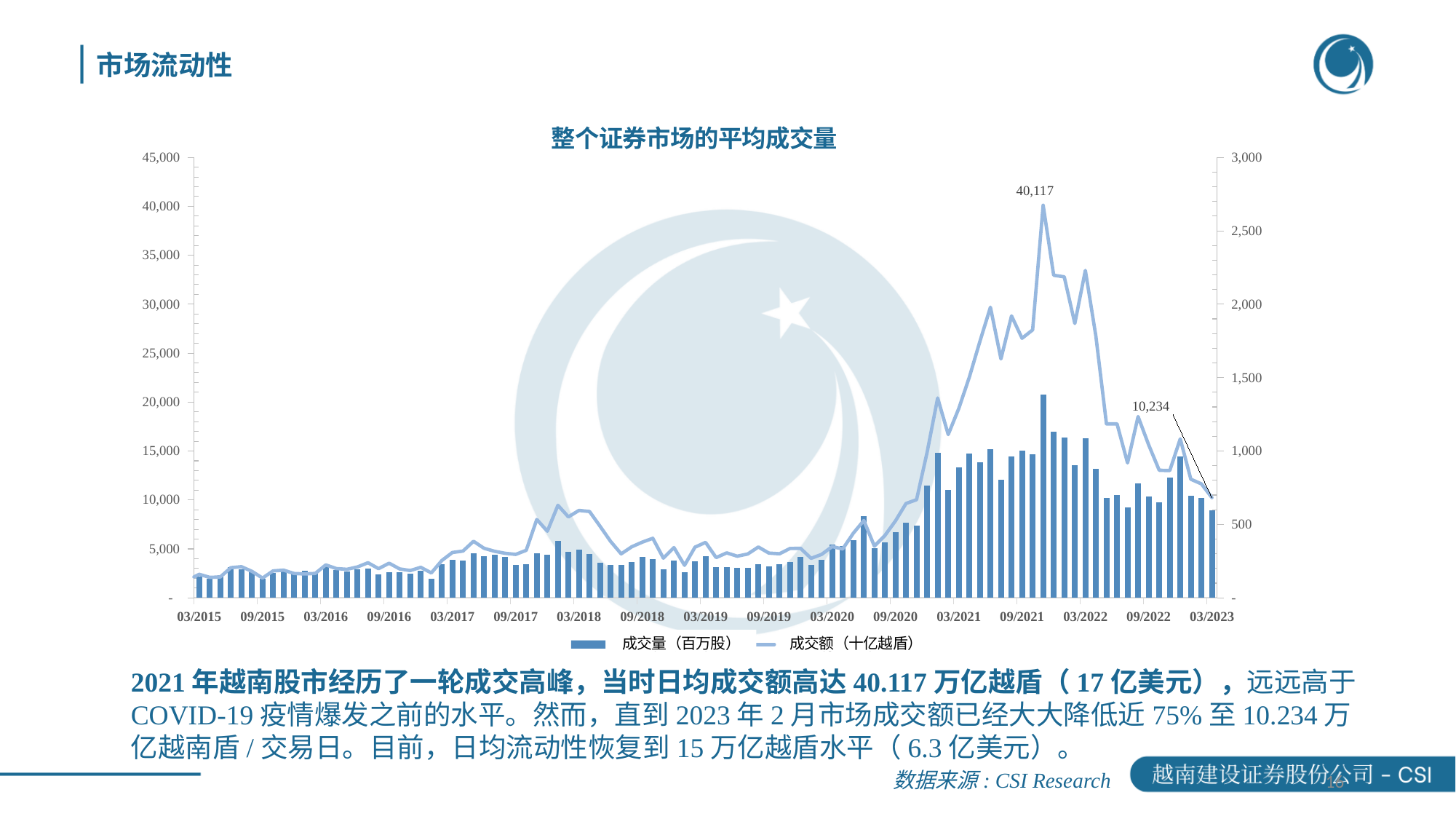
How many date labels are shown on the x axis? 17 What is the difference between the two labeled values on the 成交额 line, 40,117 and 10,234? 29,883 What kind of chart is shown on the slide? Combined bar and line chart Which is larger, the 成交量 bar at 03/2021 or the 成交量 bar at 03/2016? 03/2021 What value is labeled at the end of the 成交额 line near 03/2023? 10,234 How many series does the legend list? 2 Which series is drawn as bars according to the legend? 成交量（百万股） Does the 成交额 line rise or fall from its peak in late 2021 to 03/2023? fall Is the 成交量 bar at 03/2015 greater or less than 5,000 on the left axis? less What is the title of the chart? 整个证券市场的平均成交量 What is the peak value labeled on the 成交额 line? 40,117